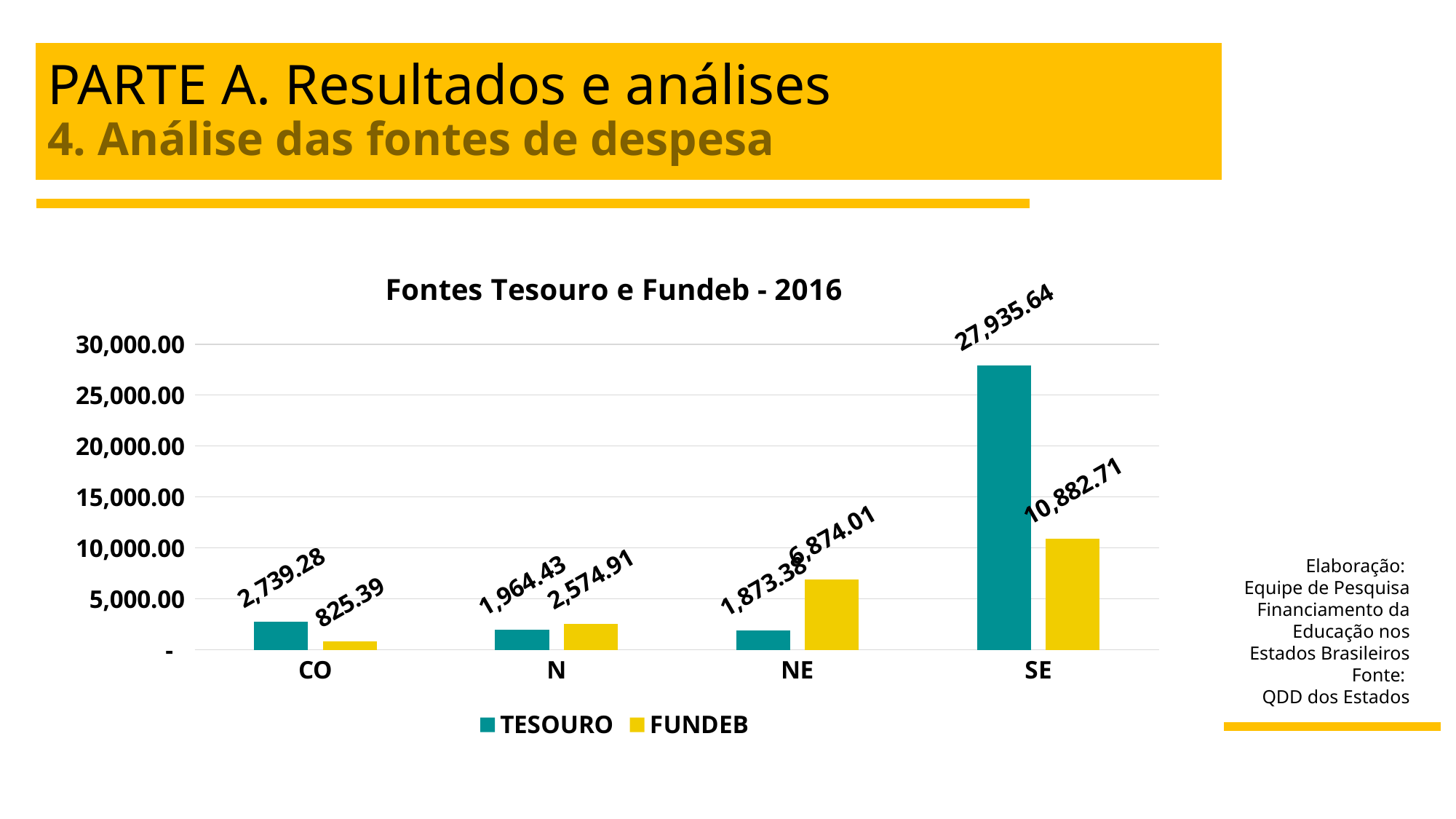
How many series does the legend list? 2 What is the TESOURO value for N? 1,964.43 How many regions are shown on the x axis? 4 What is the FUNDEB value for NE? 6,874.01 Which region has the lowest FUNDEB value? CO Is the FUNDEB value for SE greater or less than 10,000.00? greater What is the difference between the TESOURO and FUNDEB values for SE? 17,052.93 What type of chart is shown? Bar chart For NE, which is larger, TESOURO or FUNDEB? FUNDEB Which region has the highest TESOURO value? SE What is the TESOURO value for SE? 27,935.64 What is the FUNDEB value for CO? 825.39